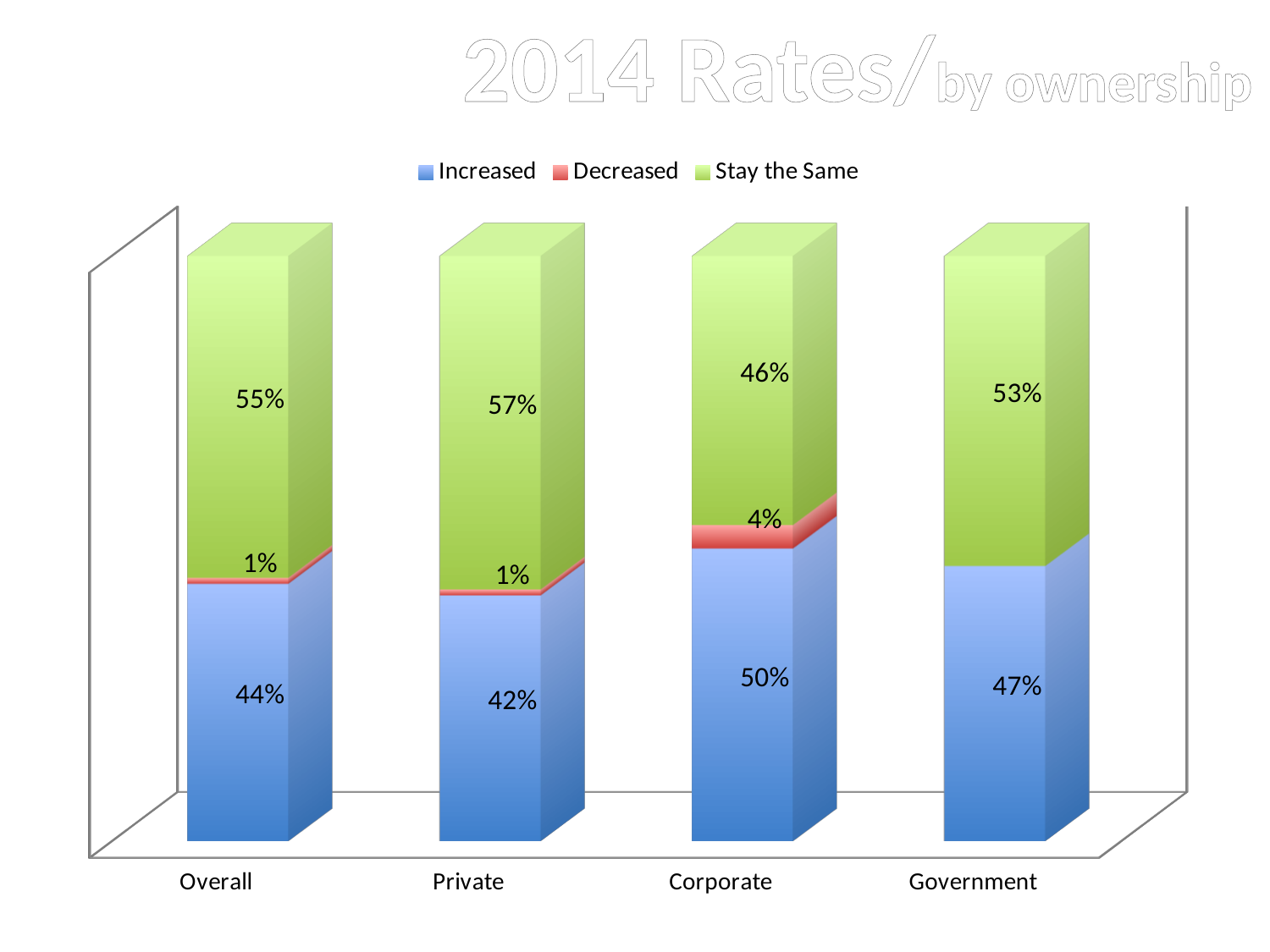
Is the 'Increased' value larger for Corporate or for Government? Corporate What is the 'Stay the Same' value for Private? 57% How many categories are shown on the x axis? 4 Which series is shown in green in the legend? Stay the Same Which category has the lowest 'Increased' value? Private What is the 'Increased' value for Government? 47% What percentage of Corporate respondents reported rates Increased? 50% How many series does the legend list? 3 Which category has the highest 'Stay the Same' value? Private What is the difference between the 'Stay the Same' values for Overall and Corporate? 9% What is the 'Decreased' value for Corporate? 4% What kind of chart is shown on the slide? Stacked bar chart